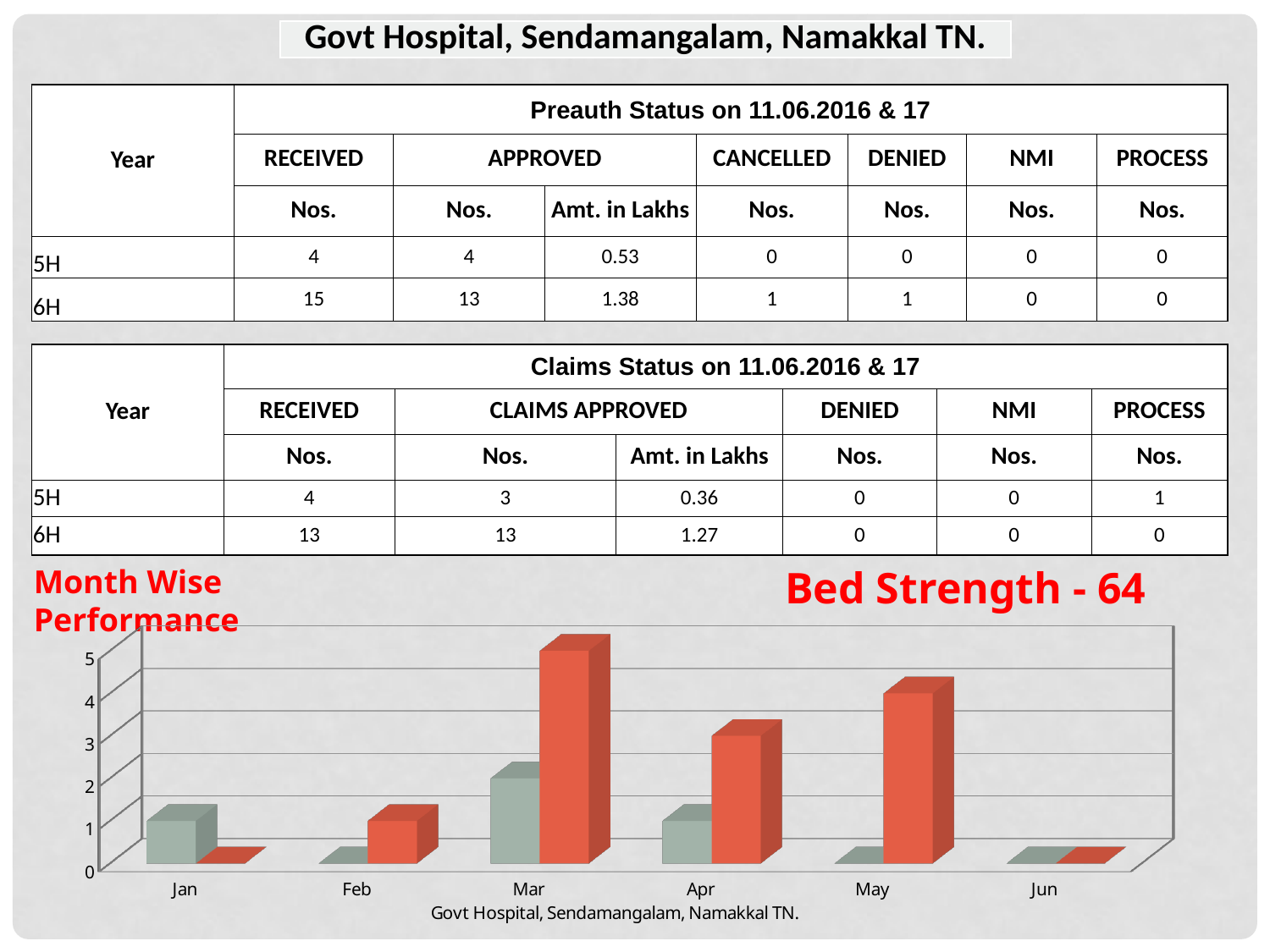
In the bar chart, which month has the tallest red bar? Mar In the bar chart, which is larger for Apr: the grey bar or the red bar? The red bar What kind of chart is shown at the bottom of the slide? Bar chart In the bar chart, what is the value of the red bar for May? 4 How many months are shown on the x axis of the bar chart? 6 In the bar chart, which month has the tallest grey bar? Mar In the bar chart, what is the value of the red bar for Apr? 3 In the bar chart, what is the value of the grey bar for Mar? 2 What text appears directly below the x axis of the bar chart? Govt Hospital, Sendamangalam, Namakkal TN. In the bar chart, what is the value of the red bar for Mar? 5 In the bar chart, is the red bar for May greater or less than 3? greater In the bar chart, what is the difference between the red bars for Mar and Apr? 2